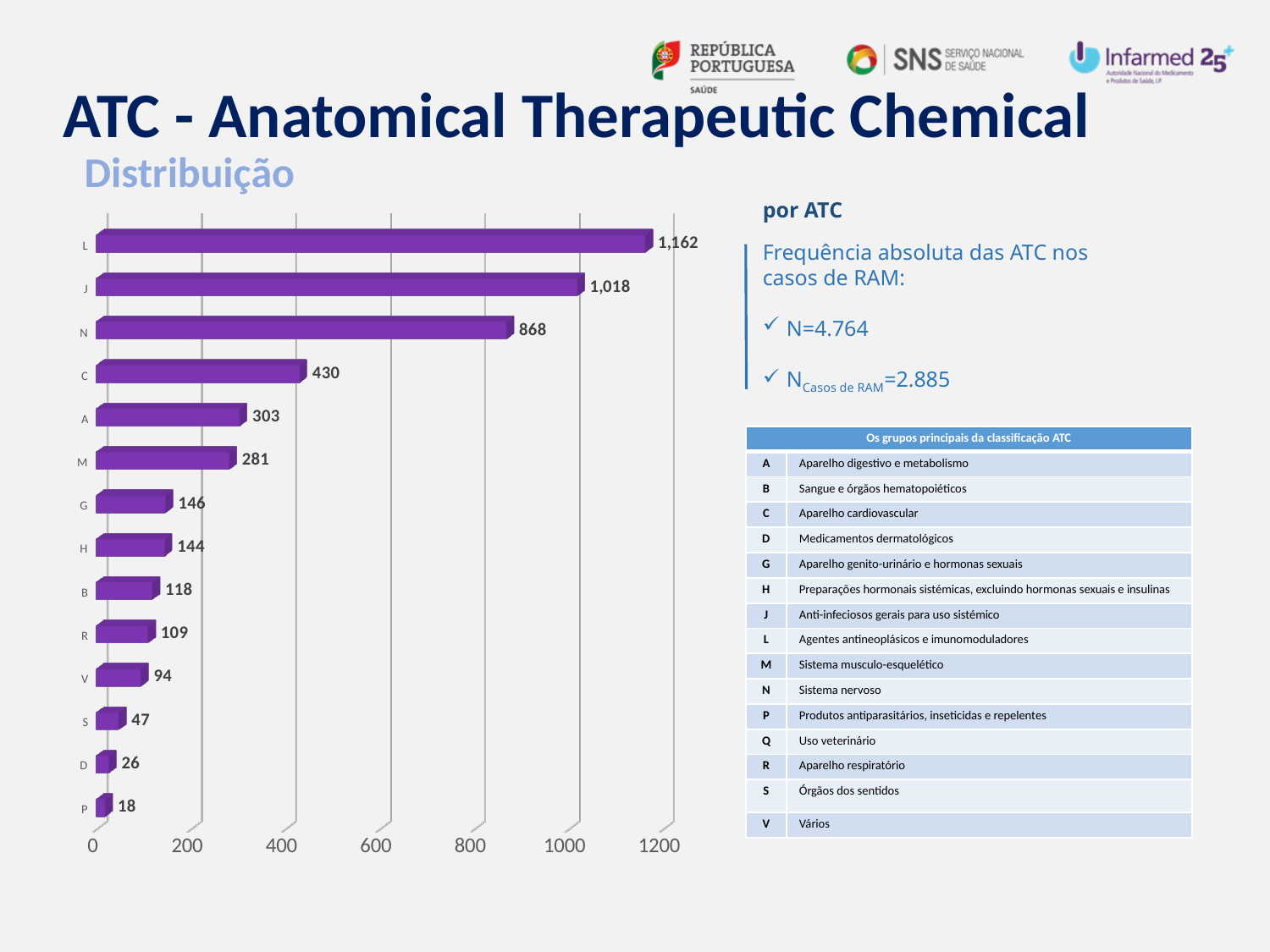
Is the value for N greater or less than 800? greater What is the value for category N? 868 What kind of chart is shown on the slide? Bar chart What is the value for category V? 94 What is the maximum value shown on the horizontal axis? 1200 Which is larger, the value for M or the value for G? M Which category has the lowest value? P What is the value for category L? 1,162 What is the difference between the values for L and J? 144 What is the difference between the values for C and A? 127 Which category has the highest value? L How many categories are shown in the chart? 14